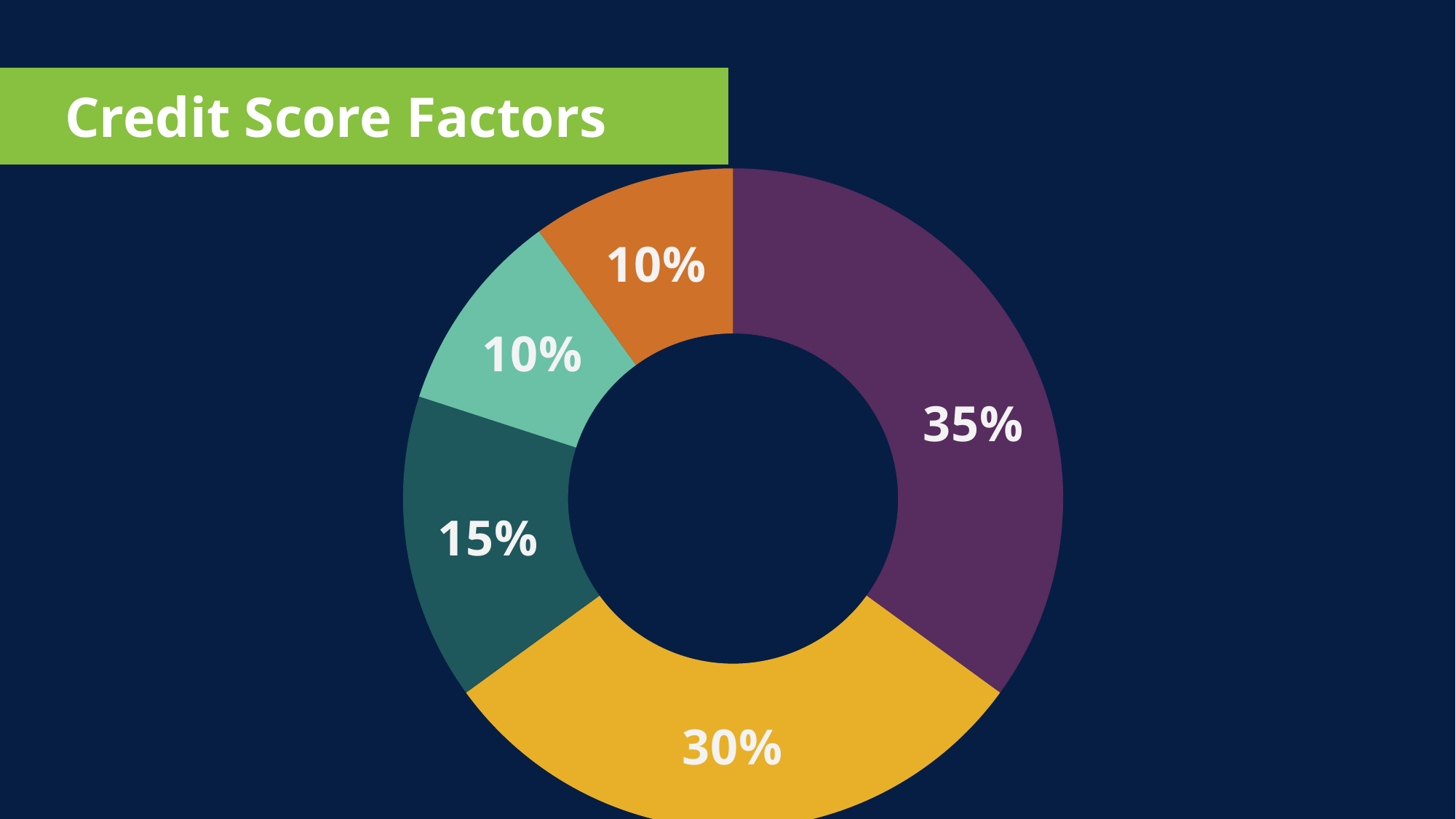
What percentage is shown on the dark green slice of the Credit Score Factors chart? 15% How many slices does the Credit Score Factors chart have? 5 What is the difference between the purple slice and the yellow slice in the Credit Score Factors chart? 5% What is the title of the chart on the slide? Credit Score Factors What is the largest percentage shown on the Credit Score Factors chart? 35% What percentage is shown on the purple slice of the Credit Score Factors chart? 35% What kind of chart is shown on the slide? Doughnut chart What is the smallest percentage shown on the Credit Score Factors chart? 10% Which slice is larger in the Credit Score Factors chart, the dark green slice or the light green slice? The dark green slice What percentage is shown on the yellow slice of the Credit Score Factors chart? 30% What percentage is shown on the orange slice of the Credit Score Factors chart? 10% How many slices in the Credit Score Factors chart are labelled 10%? 2